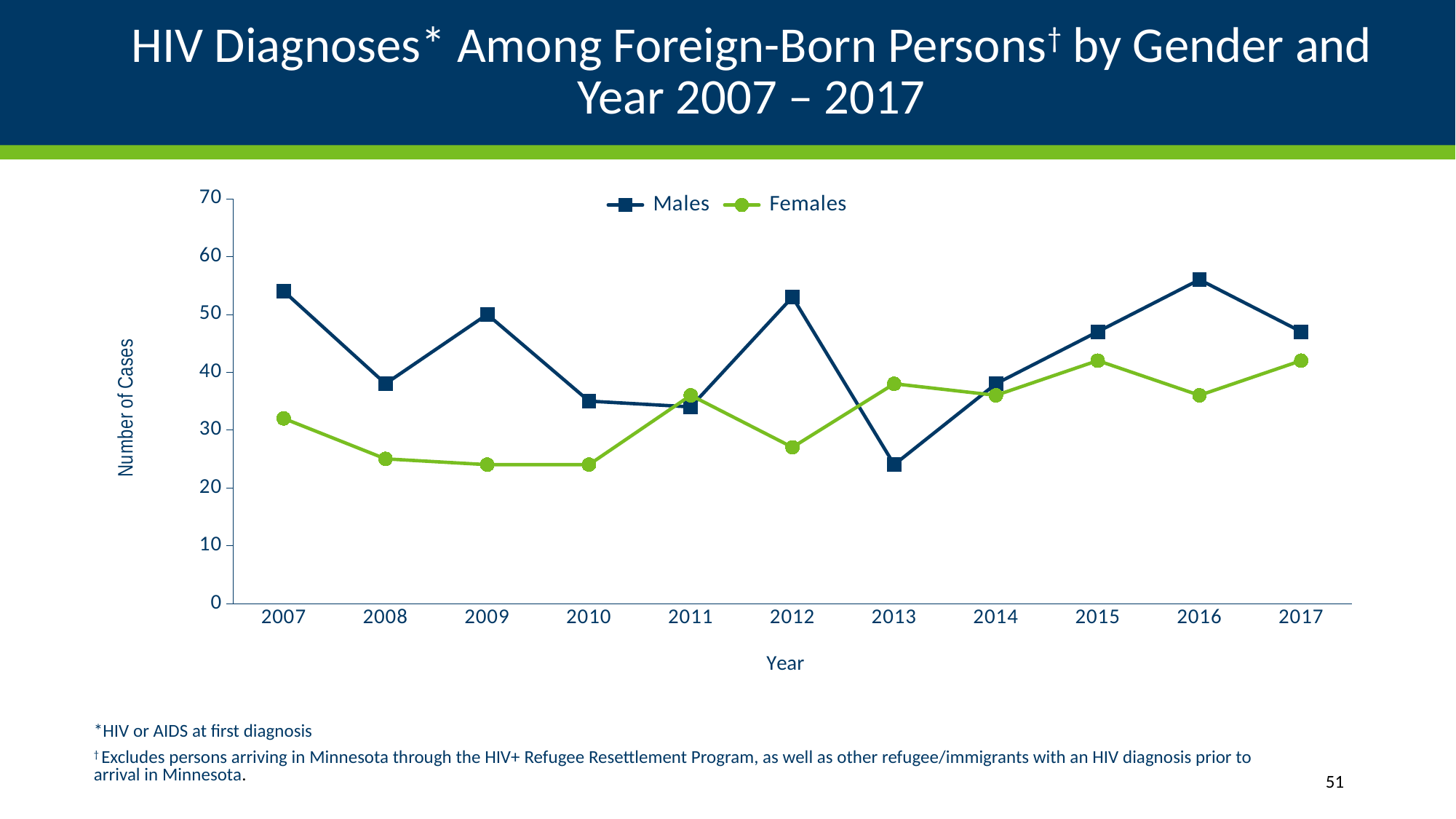
Do the Females values rise or fall from 2007 to 2010? fall How many series does the legend list? 2 Is the Females value for 2008 greater or less than 30? less How many years are plotted along the x axis? 11 In 2013, which series has the higher value, Males or Females? Females Is the Males value for 2013 greater or less than 30? less In which year is the Males value lowest? 2013 Is the Males value for 2016 greater or less than 50? greater What kind of chart is shown on the slide? line chart In 2007, which series has the higher value, Males or Females? Males What is the label on the y axis? Number of Cases